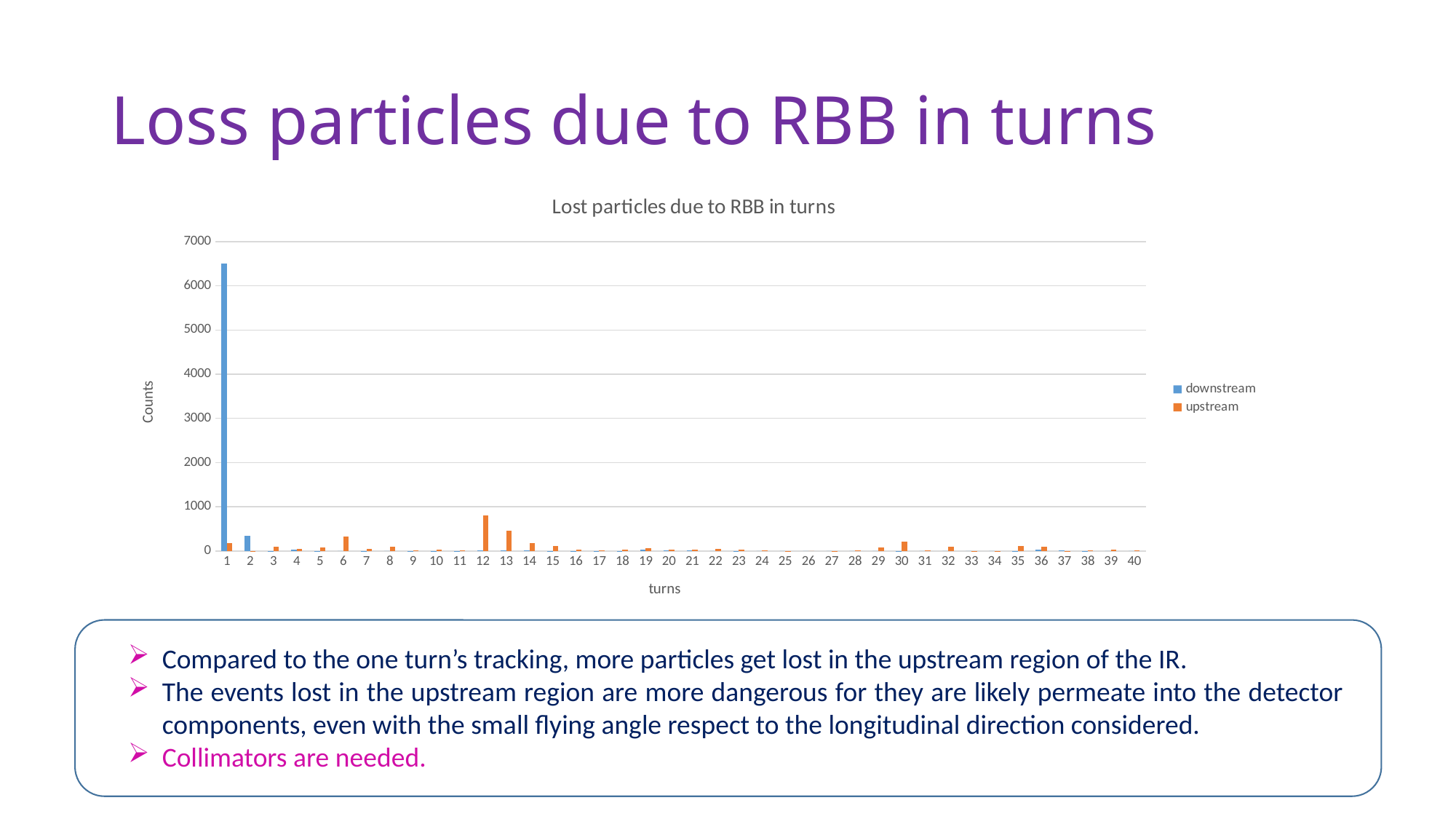
For the upstream series, which turn has the larger value, turn 12 or turn 13? turn 12 At turn 1, which series has the larger value, downstream or upstream? downstream What is the label of the y axis? Counts How many series does the legend list? 2 What is the title of the chart? Lost particles due to RBB in turns Is the downstream value at turn 1 greater or less than 6000? greater At which turn is the downstream count highest? 1 What kind of chart is shown on the slide? bar chart Is the upstream value at turn 13 greater or less than 1000? less At which turn is the upstream count highest? 12 Is the upstream value at turn 12 greater or less than 1000? less How many turns are shown along the x axis? 40